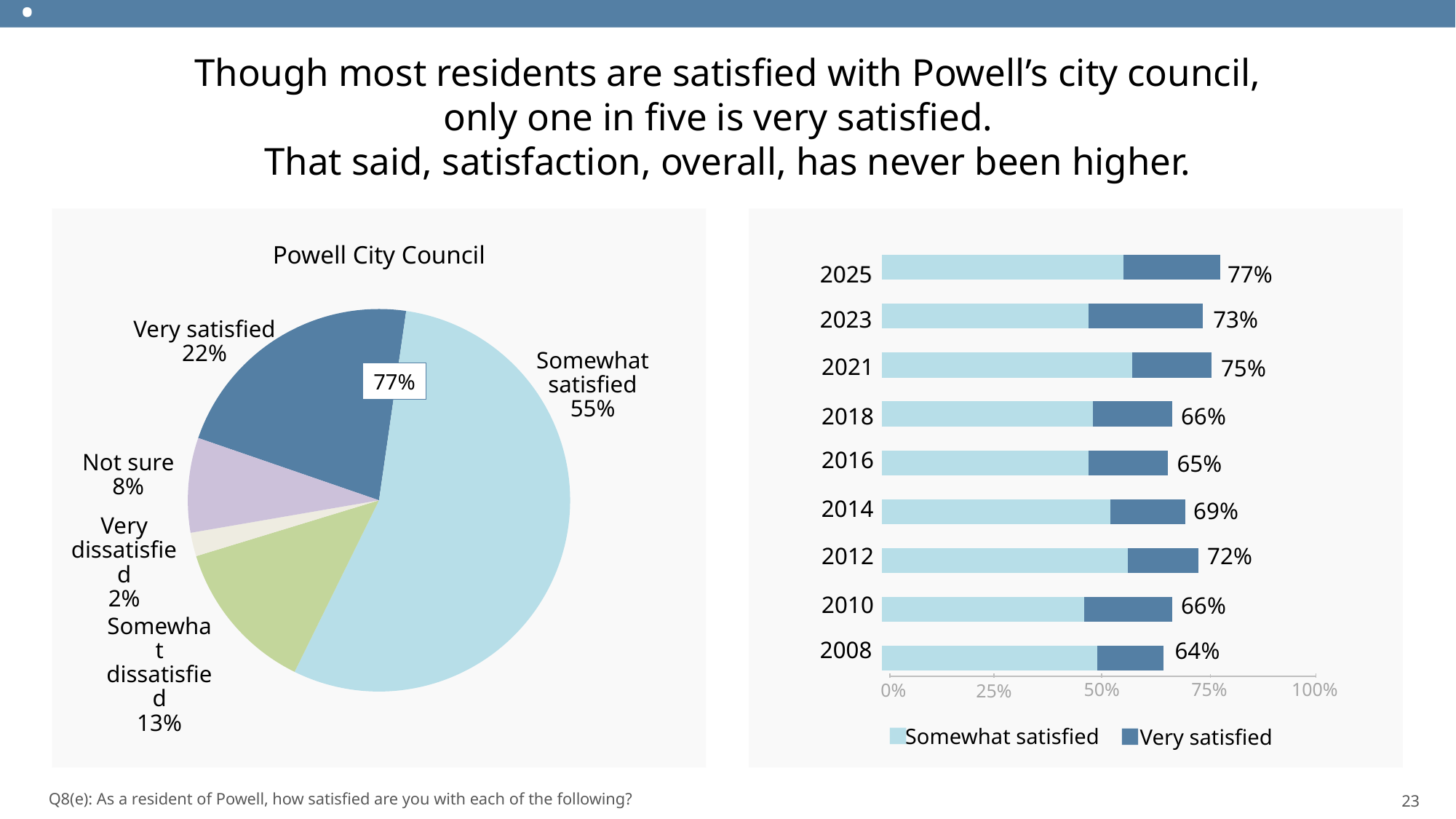
How many slices does the Powell City Council pie chart have? 5 In the Powell City Council pie chart, which category has the largest share? Somewhat satisfied In the Powell City Council pie chart, what share of residents are very satisfied? 22% How many years are shown in the bar chart on the right? 9 In the Powell City Council pie chart, which category has the smallest share? Very dissatisfied In the bar chart on the right, which year has the lowest total satisfied percentage? 2008 What kind of chart is the chart on the left of the slide? Pie chart In the bar chart on the right, how many percentage points higher is the 2025 total than the 2008 total? 13 percentage points In the bar chart on the right, which year has the highest total satisfied percentage? 2025 In the Powell City Council pie chart, how many percentage points larger is the somewhat satisfied share than the very satisfied share? 33 percentage points In the bar chart on the right, what is the total satisfied percentage for 2025? 77% How many series does the legend of the bar chart on the right list? 2